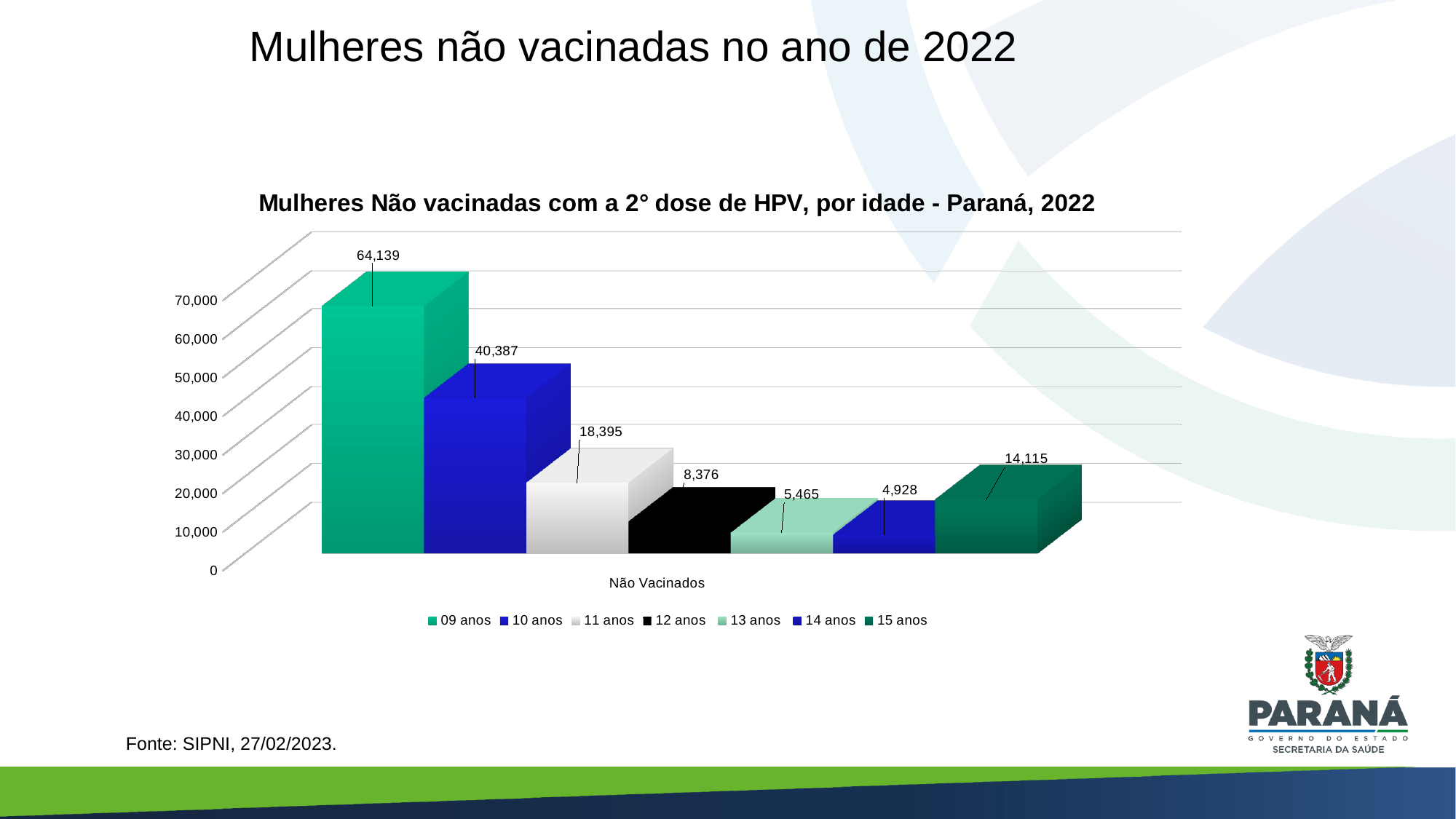
Which is larger, the value for 11 anos or the value for 15 anos? 11 anos What is the value for 12 anos? 8,376 Which age group has the highest number of unvaccinated women? 09 anos Which age group has the lowest number of unvaccinated women? 14 anos How many series does the legend list? 7 What is the title of the chart? Mulheres Não vacinadas com a 2° dose de HPV, por idade - Paraná, 2022 What kind of chart is shown on the slide? bar chart What is the difference between the values for 09 anos and 10 anos? 23,752 What is the difference between the values for 15 anos and 13 anos? 8,650 Is the value for 10 anos greater or less than 30,000? greater What is the value for 15 anos? 14,115 What is the value for 09 anos? 64,139